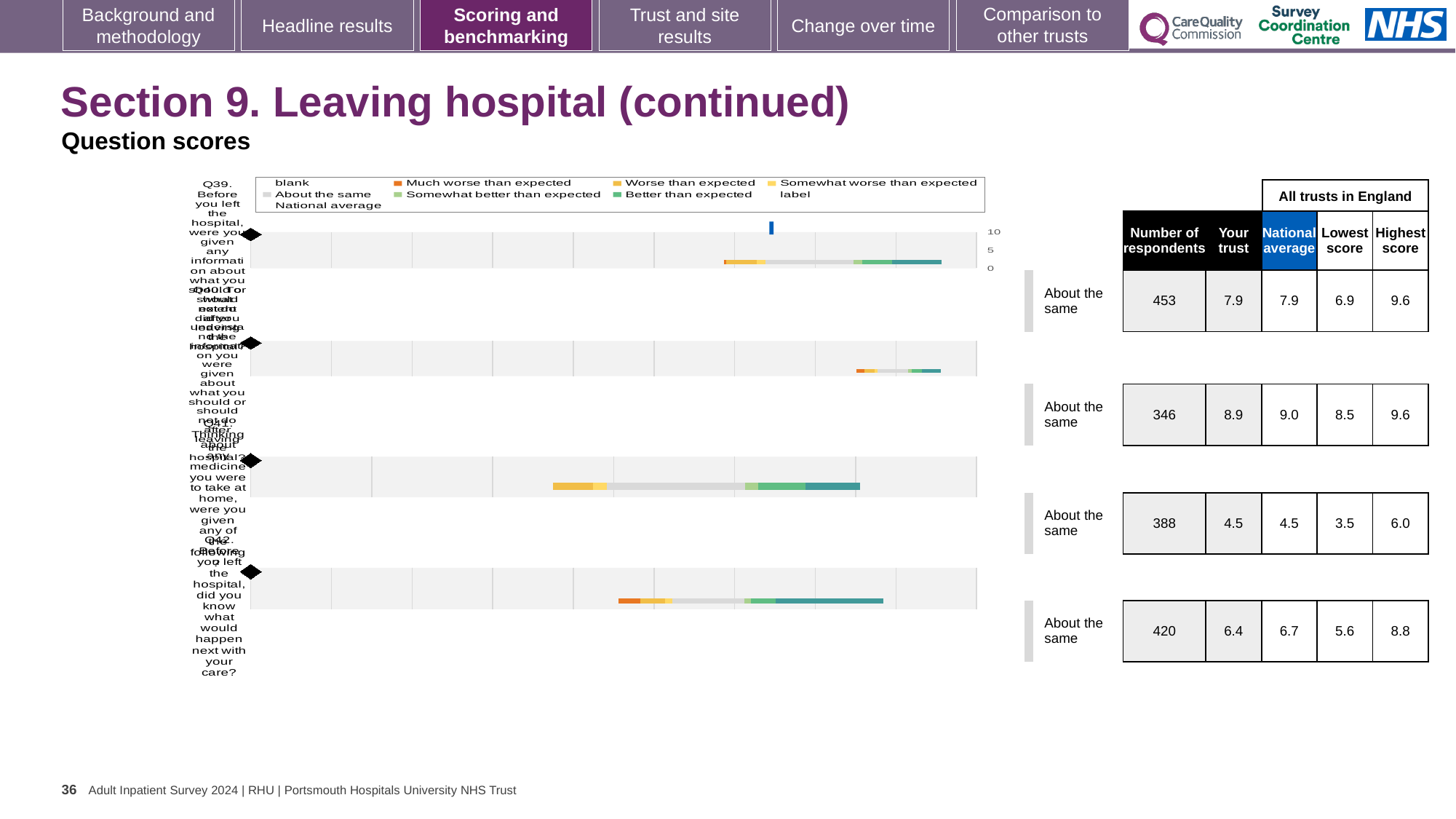
In the table beside the chart, is the 'Your trust' score for the second row larger or smaller than its national average? smaller Which question number is labelled at the top of the chart? Q39 Which question number is labelled at the bottom of the chart? Q42 In the table beside the chart, what is the 'Your trust' score for the last row (Q42)? 6.4 How many question rows (diamond markers) does the chart show? 4 In the table beside the chart, what is the 'Your trust' score for the first row (Q39)? 7.9 In the table beside the chart, what is the number of respondents for the first row (Q39)? 453 In the table beside the chart, which row has the lowest 'Your trust' score? the third row (4.5) In the table beside the chart, what is the difference between the highest score and the lowest score for the last row (Q42)? 3.2 In the table beside the chart, which row has the highest 'Your trust' score? the second row (8.9) In the table beside the chart, what is the national average for the last row (Q42)? 6.7 What kind of chart is shown on the slide? bar chart